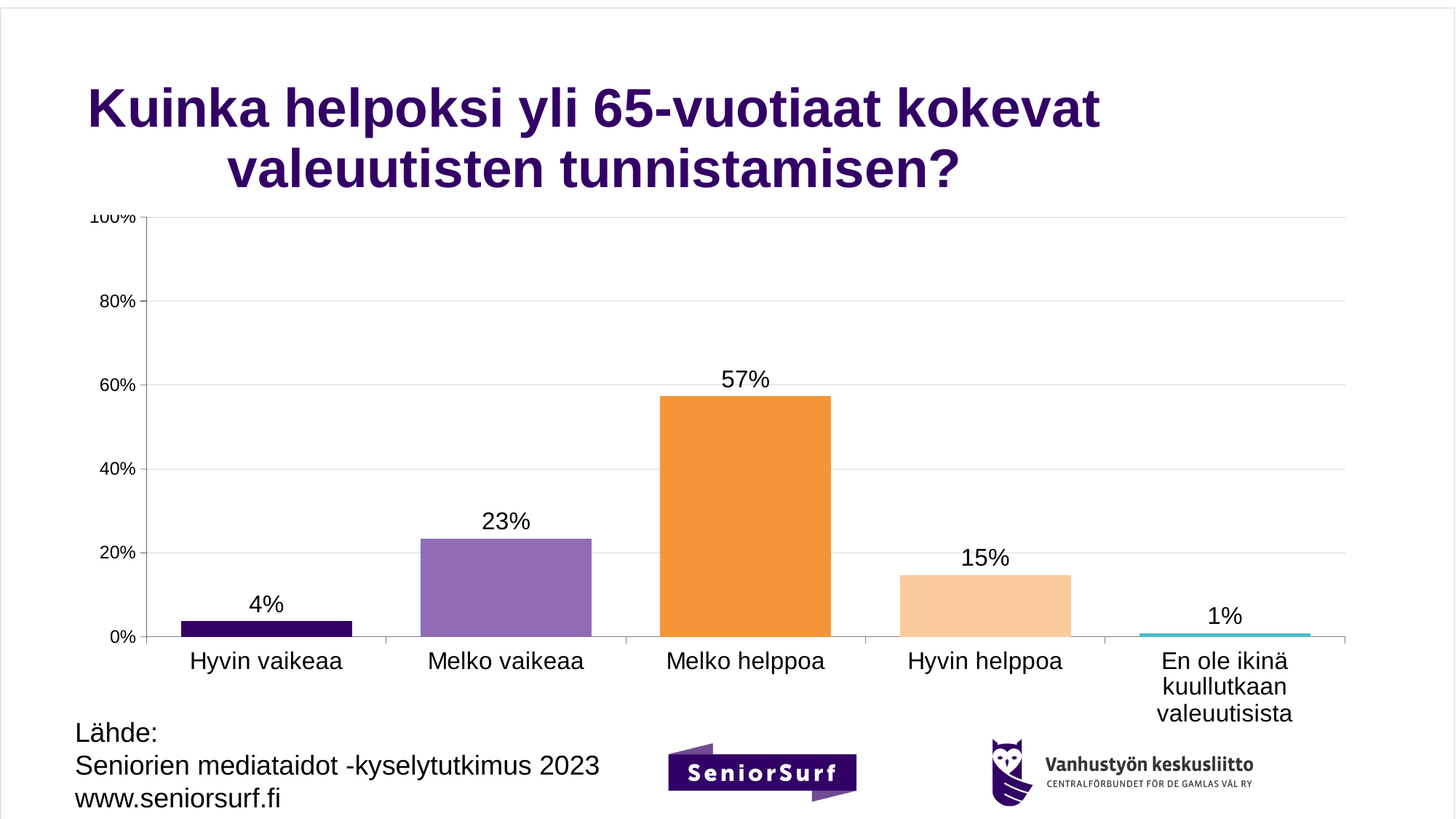
Which category has the highest value? Melko helppoa How many categories are shown on the x axis? 5 Which category has the lowest value? En ole ikinä kuullutkaan valeuutisista What is the value for "En ole ikinä kuullutkaan valeuutisista"? 1% What is the value for "Hyvin vaikeaa"? 4% What is the title of the chart? Kuinka helpoksi yli 65-vuotiaat kokevat valeuutisten tunnistamisen? What kind of chart is shown on the slide? Bar chart What is the difference between the values for "Melko helppoa" and "Melko vaikeaa"? 34 percentage points What is the value for "Hyvin helppoa"? 15% What percentage of respondents answered "Melko helppoa"? 57% Is the value for "Melko helppoa" greater or less than 40%? greater Which is larger, the value for "Melko vaikeaa" or the value for "Hyvin helppoa"? Melko vaikeaa